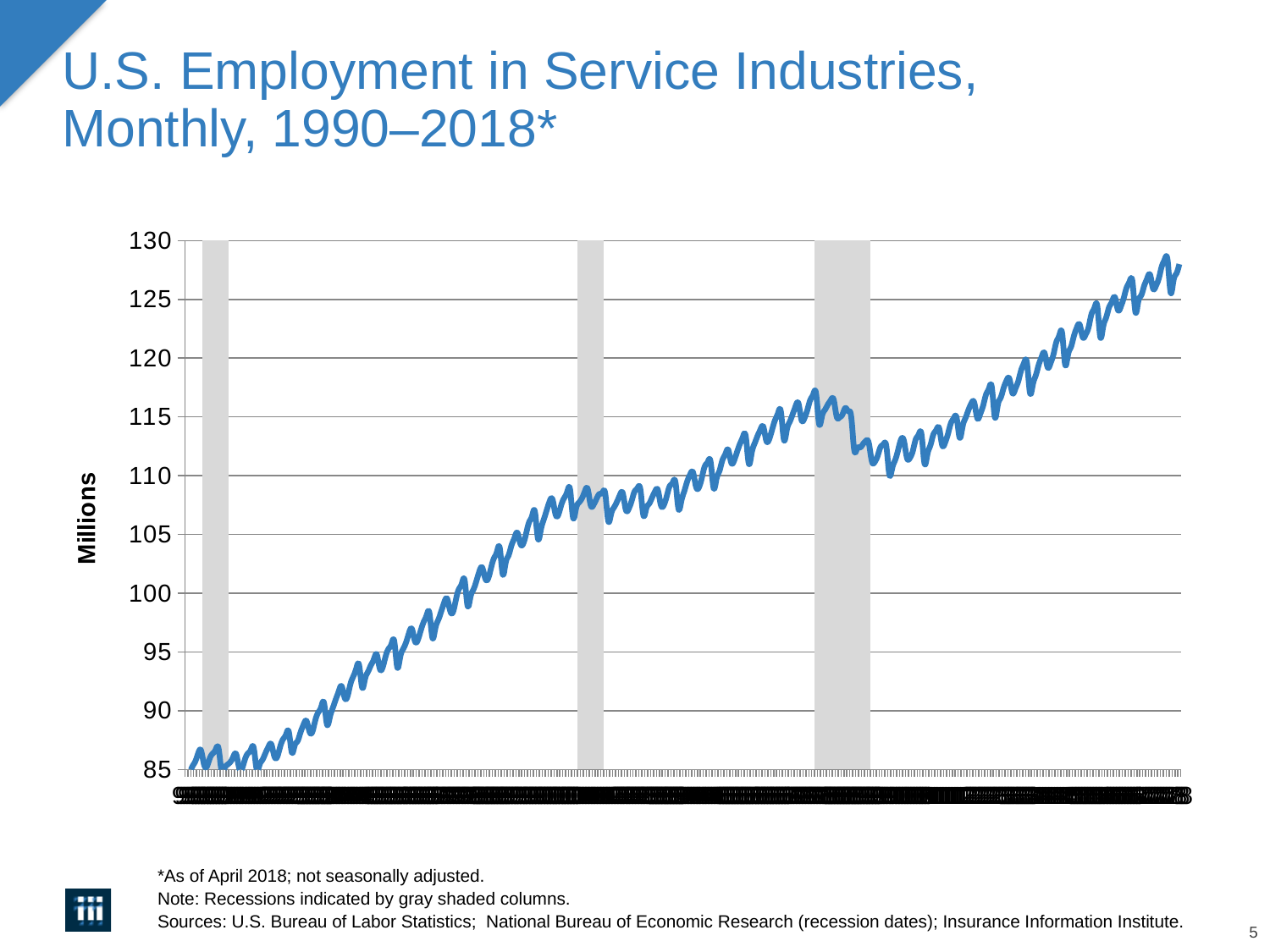
What is the title of the chart? U.S. Employment in Service Industries, Monthly, 1990–2018* What kind of chart is shown on the slide? line chart What is the highest value shown on the vertical axis? 130 Overall, do the values rise or fall from left to right along the x axis? rise Is the value at the end of the series (2018) greater or less than 125? greater Is the value at the start of the series (1990) greater or less than 90? less What is the label on the vertical axis? Millions How many lines are plotted on the chart? 1